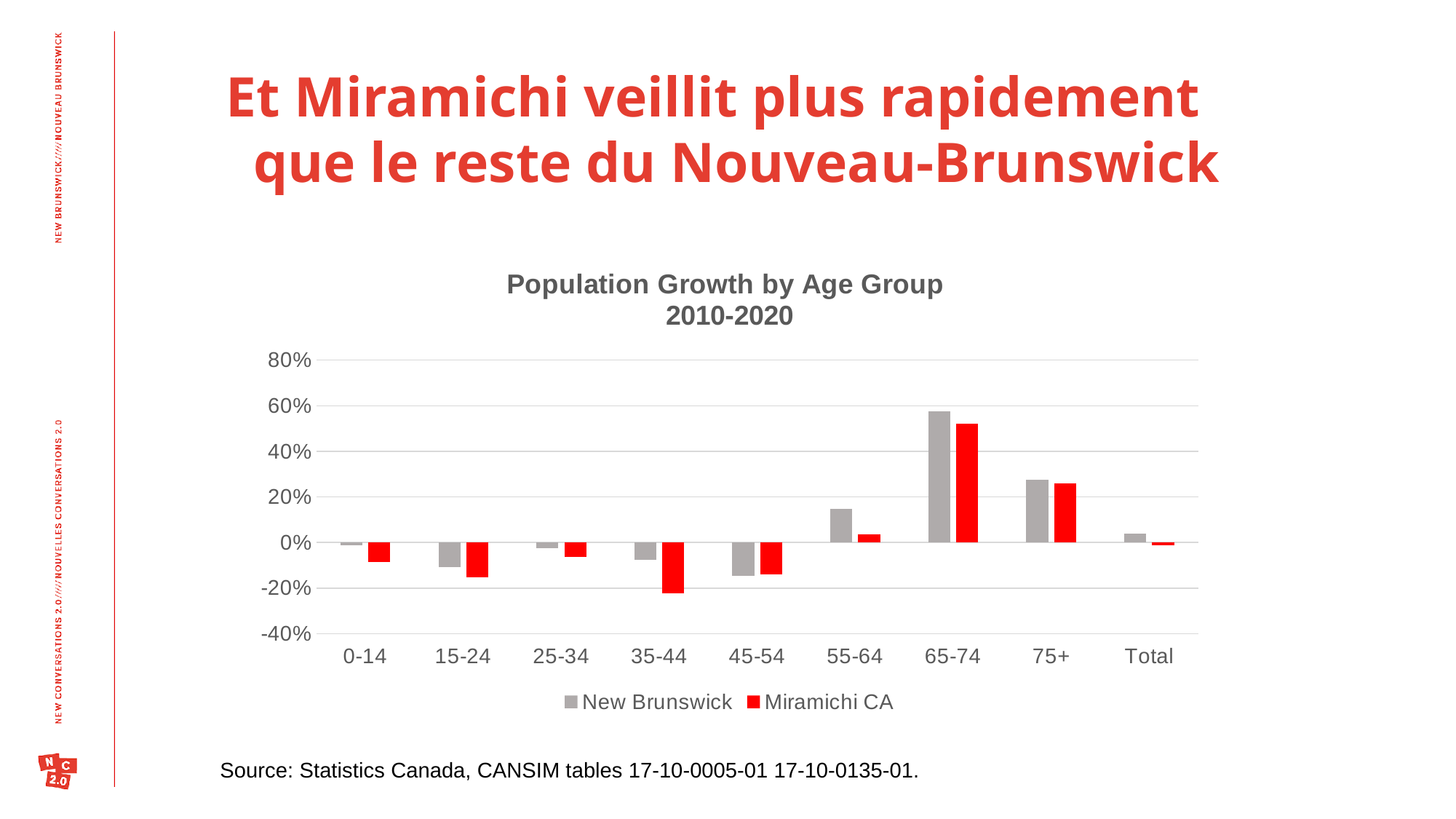
How many series does the legend list? 2 Which age group has the highest population growth for New Brunswick? 65-74 Is the New Brunswick value for 65-74 greater or less than 40%? greater For the 55-64 age group, which series has the larger value, New Brunswick or Miramichi CA? New Brunswick For the 35-44 age group, which series has the lower value, New Brunswick or Miramichi CA? Miramichi CA Which age group has the highest population growth for Miramichi CA? 65-74 Is the Miramichi CA value for 35-44 greater or less than -20%? less Is the Miramichi CA value for 55-64 greater or less than 20%? less What colour are the bars for Miramichi CA? Red What kind of chart is shown on the slide? Bar chart How many categories are shown on the x axis? 9 Which age group has the lowest population growth for Miramichi CA? 35-44